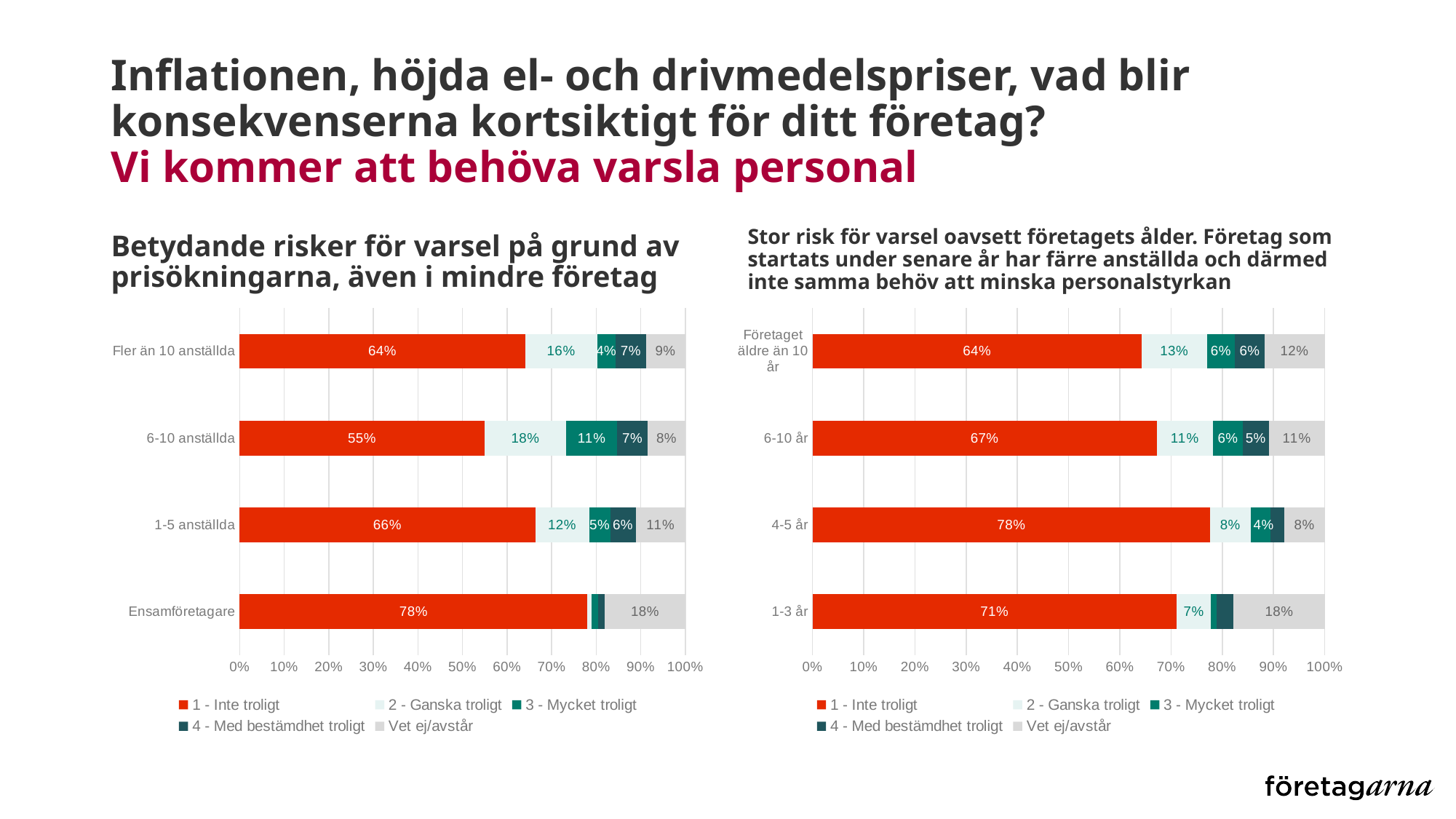
How many categories are shown in the right chart? 4 In the right chart, what is the value of 'Vet ej/avstår' for '1-3 år'? 18% In the left chart, what is the difference between the '2 - Ganska troligt' values for '6-10 anställda' and '1-5 anställda'? 6% In the right chart, what is the value of '1 - Inte troligt' for '4-5 år'? 78% In the left chart, which category has the lowest value for '1 - Inte troligt'? 6-10 anställda What type of chart is the left chart? Stacked bar chart In the left chart, what is the value of '1 - Inte troligt' for '6-10 anställda'? 55% In the right chart, is the '1 - Inte troligt' value for '6-10 år' larger or smaller than for '1-3 år'? smaller In the right chart, which category has the lowest value for '1 - Inte troligt'? Företaget äldre än 10 år How many series does the legend of the left chart list? 5 In the left chart, what is the value of 'Vet ej/avstår' for 'Ensamföretagare'? 18% In the left chart, which category has the highest value for '1 - Inte troligt'? Ensamföretagare